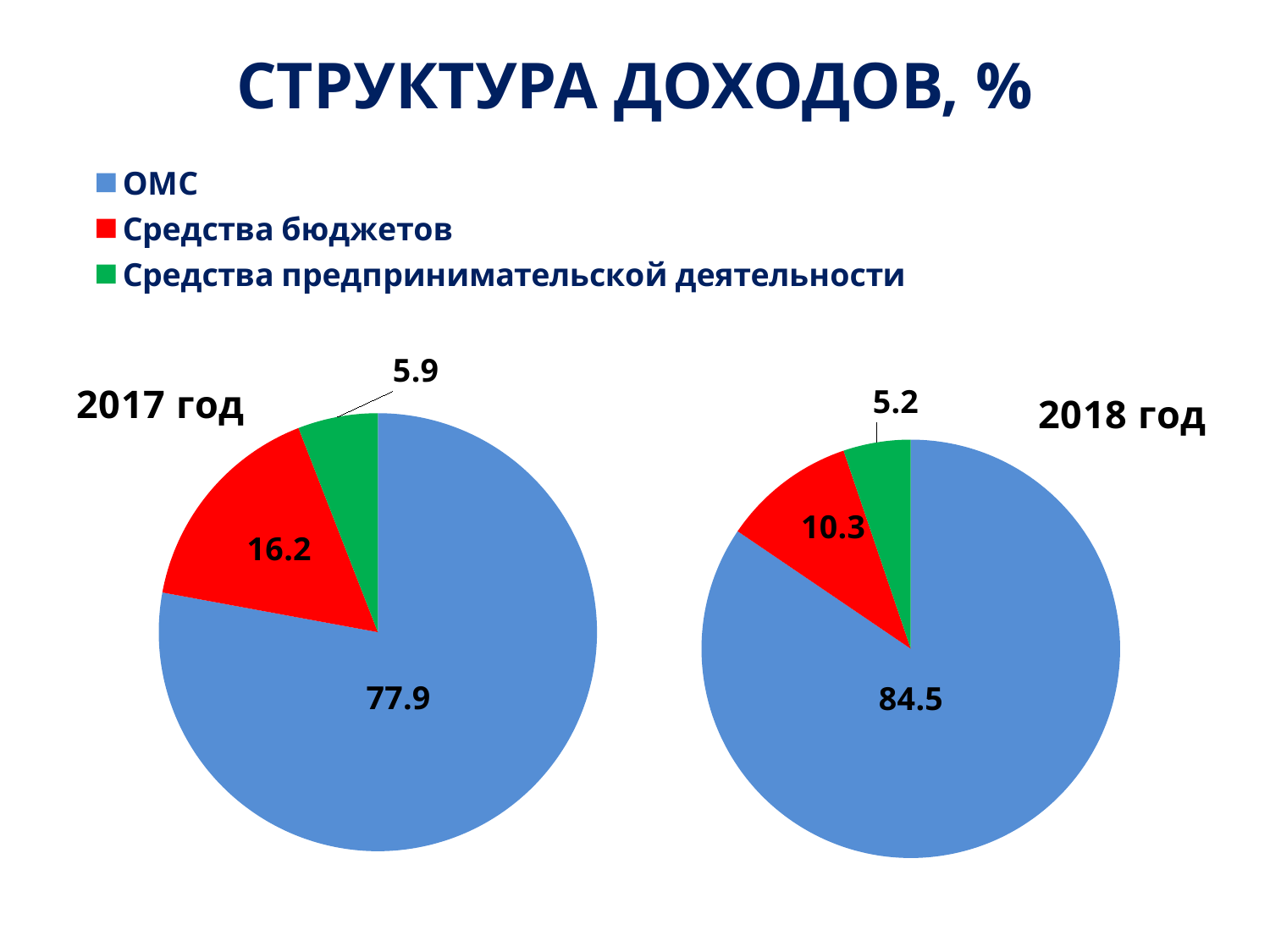
In the 2018 год pie chart, which category has the smallest slice? Средства предпринимательской деятельности In the 2017 год pie chart, what is the value for Средства предпринимательской деятельности? 5.9 In the 2017 год pie chart, which category has the largest slice? ОМС In the 2018 год pie chart, what is the value for Средства бюджетов? 10.3 How many entries does the legend list? 3 In the 2018 год pie chart, what is the value for ОМС? 84.5 What is the difference between the Средства бюджетов value in the 2017 год chart and in the 2018 год chart? 5.9 How many slices does the 2017 год pie chart have? 3 In the 2017 год pie chart, what is the value for ОМС? 77.9 Which is larger: the ОМС value in the 2017 год chart or in the 2018 год chart? 2018 год What colour represents Средства бюджетов in the charts? Red What type of chart is used on this slide? Pie chart